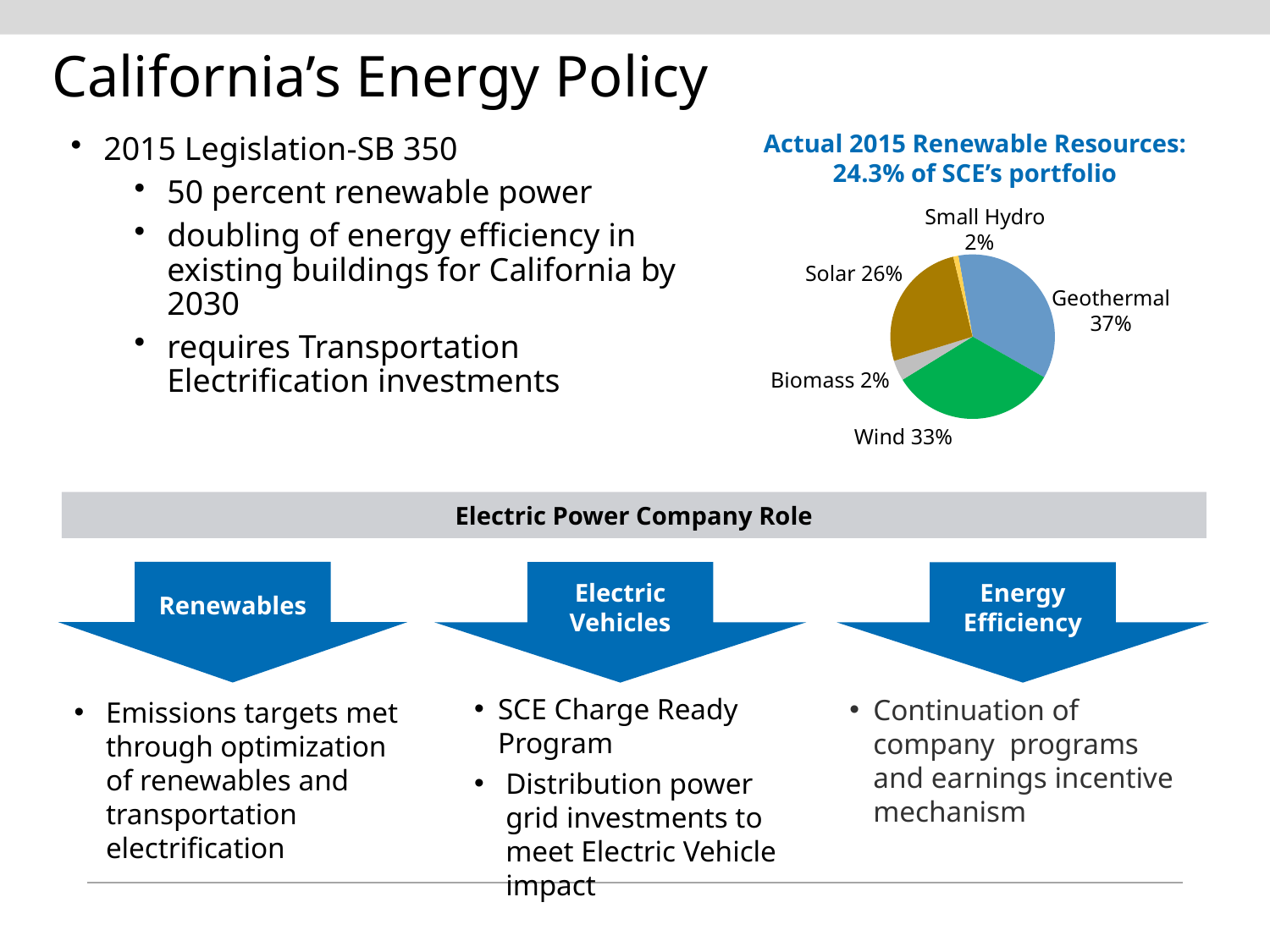
What is the difference in percentage points between the Solar share and the Small Hydro share? 24 What is the title of the pie chart? Actual 2015 Renewable Resources: 24.3% of SCE's portfolio How many slices does the pie chart have? 5 What share of the pie does Solar have? 26% What share of the pie does Geothermal have? 37% Which renewable resource has the largest share of the pie? Geothermal What is the difference in percentage points between the Geothermal share and the Wind share? 4 What share of the pie does Wind have? 33% What is the combined share of Geothermal and Wind in the pie chart? 70% What share of the pie does Biomass have? 2% What kind of chart is shown on the slide? Pie chart Which is larger, the share for Wind or the share for Solar? Wind